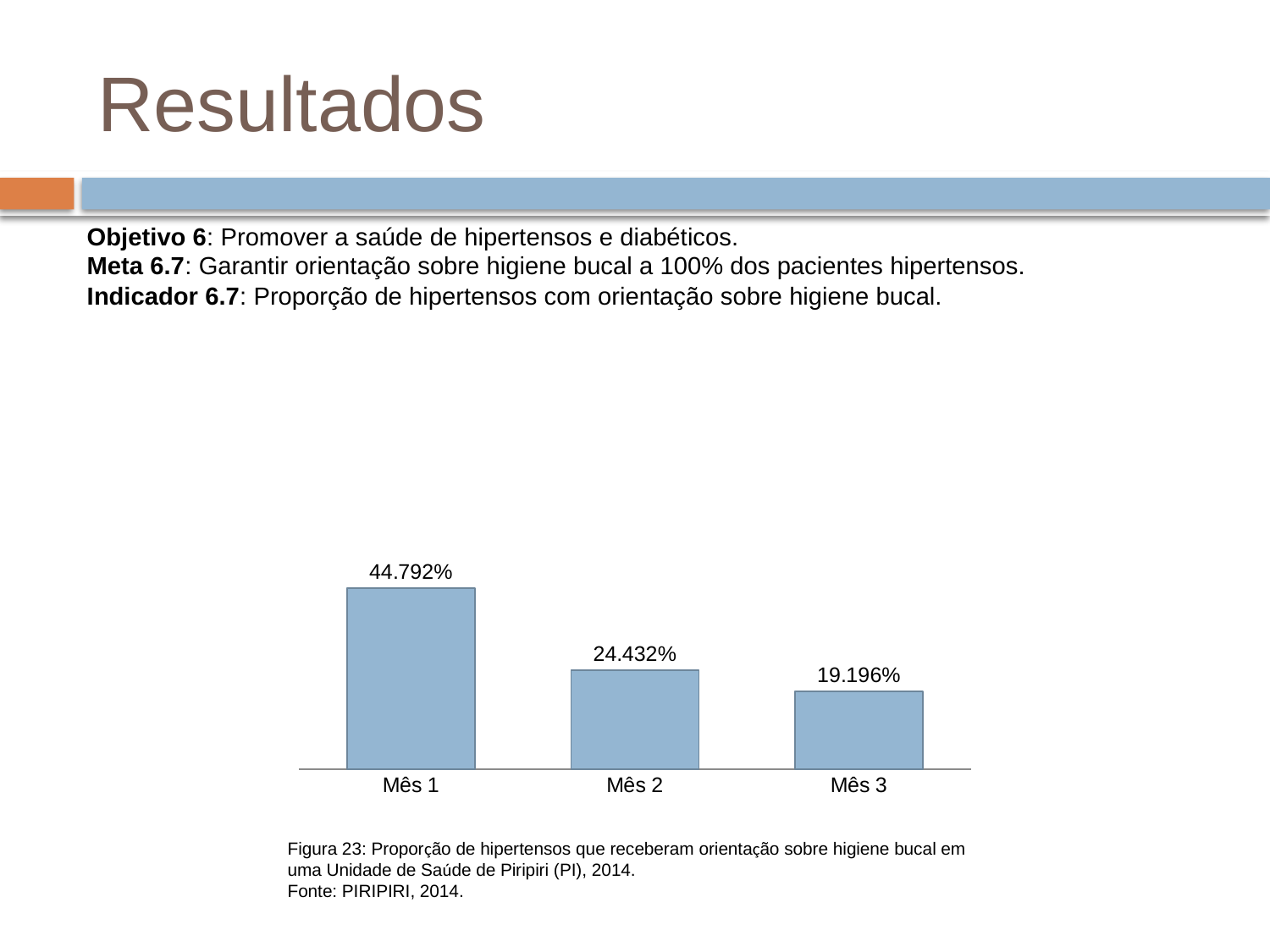
Which month has the highest value? Mês 1 What is the difference between the values for Mês 2 and Mês 3? 5.236% What is the value for Mês 1? 44.792% What is the value for Mês 2? 24.432% How many bars are shown in the chart? 3 What is the difference between the values for Mês 1 and Mês 3? 25.596% What is the value for Mês 3? 19.196% Which month has the lowest value? Mês 3 What is the difference between the values for Mês 1 and Mês 2? 20.360% Which is larger, the value for Mês 2 or the value for Mês 3? Mês 2 Do the values rise or fall from Mês 1 to Mês 3? Fall What kind of chart is shown on the slide? Bar chart